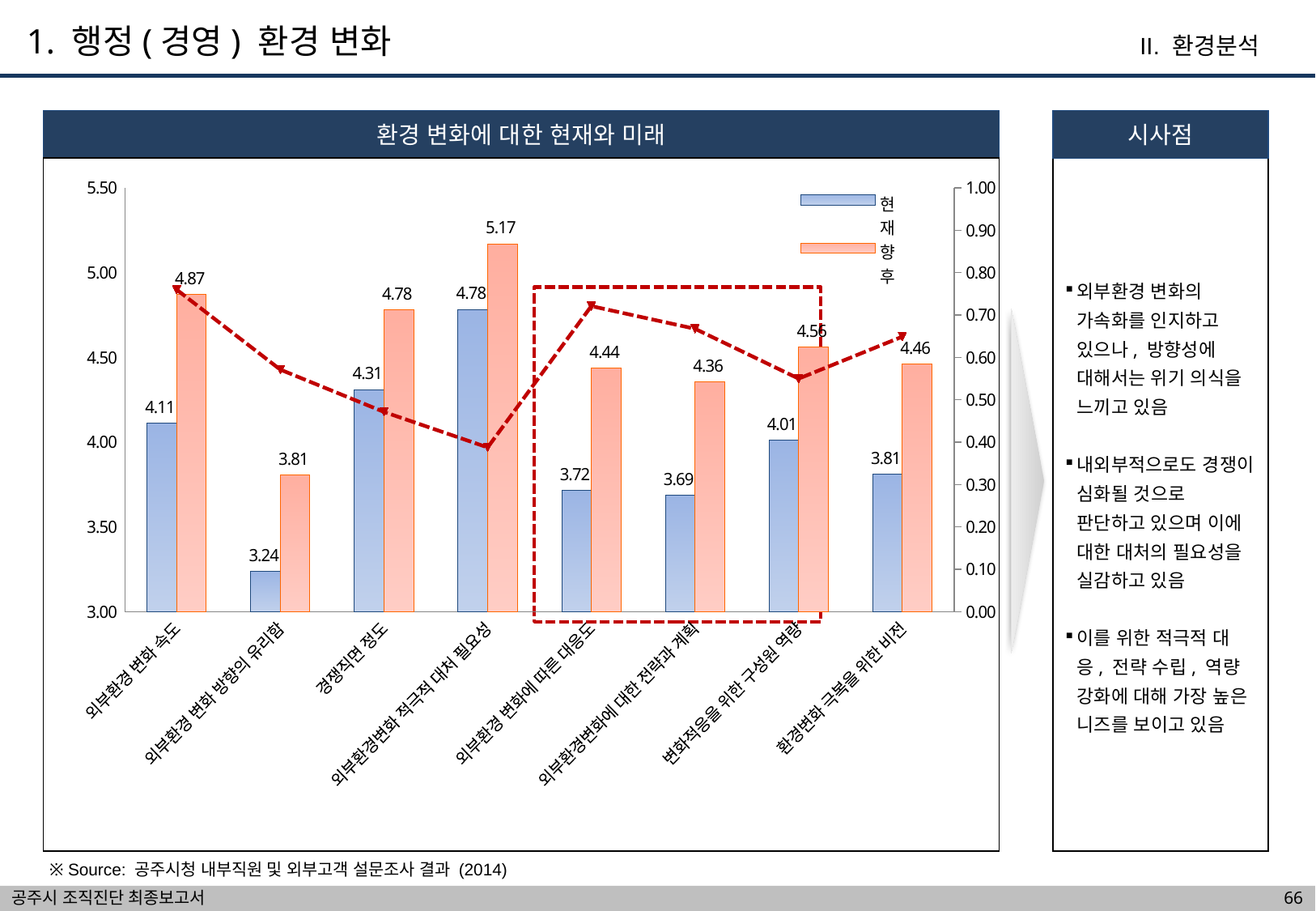
Which category has the highest 향후 value? 외부환경변화 적극적 대처 필요성 What is the difference between the 향후 and 현재 values for 외부환경 변화 속도? 0.76 What is the 향후 value for 외부환경 변화에 따른 대응도? 4.44 What is the 향후 value for 외부환경변화 적극적 대처 필요성? 5.17 How many categories are shown on the x axis of the chart? 8 What is the 현재 value for 변화적응을 위한 구성원 역량? 4.01 Is the 향후 value for 외부환경 변화 방향의 유리함 greater or less than 4.00? less Which is larger, the 현재 value for 경쟁직면 정도 or the 현재 value for 환경변화 극복을 위한 비전? 경쟁직면 정도 Which category has the lowest 현재 value? 외부환경 변화 방향의 유리함 What is the 현재 value for 외부환경 변화 속도? 4.11 What is the title of the chart? 환경 변화에 대한 현재와 미래 How many series does the legend list? 2